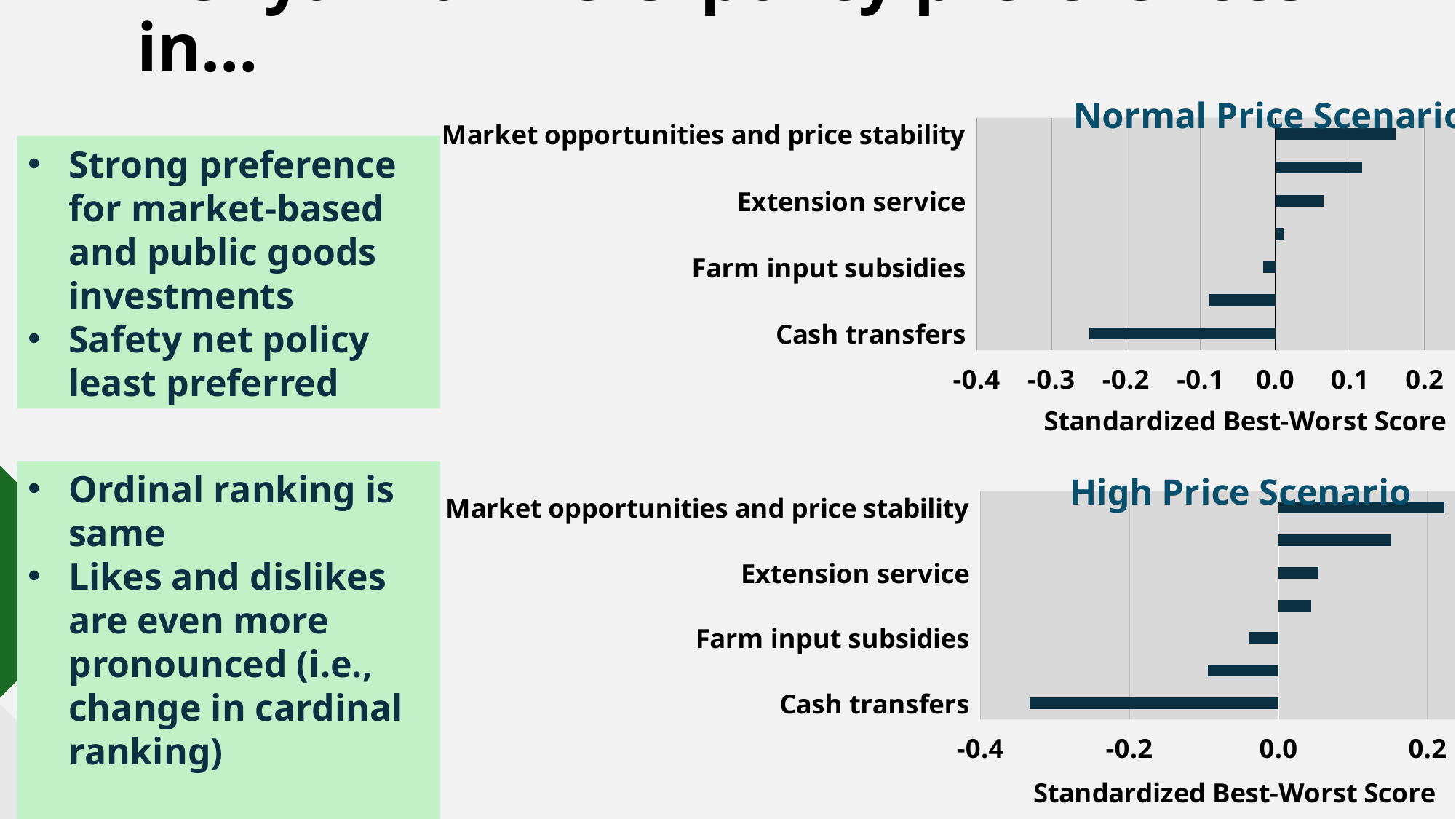
In the Normal Price Scenario chart, which is larger: the value for Extension service or the value for Farm input subsidies? Extension service In the Normal Price Scenario chart, which labeled category has the lowest Standardized Best-Worst Score? Cash transfers In the High Price Scenario chart, which labeled category has the highest Standardized Best-Worst Score? Market opportunities and price stability In the High Price Scenario chart, is the value for Market opportunities and price stability greater or less than 0.2? greater In the Normal Price Scenario chart, which labeled category has the highest Standardized Best-Worst Score? Market opportunities and price stability In the High Price Scenario chart, is the value for Farm input subsidies greater or less than 0.0? less What kind of chart is the Normal Price Scenario chart? bar chart In the High Price Scenario chart, is the value for Cash transfers greater or less than -0.2? less In the High Price Scenario chart, which labeled category has the lowest Standardized Best-Worst Score? Cash transfers What is the x-axis title of the Normal Price Scenario chart? Standardized Best-Worst Score